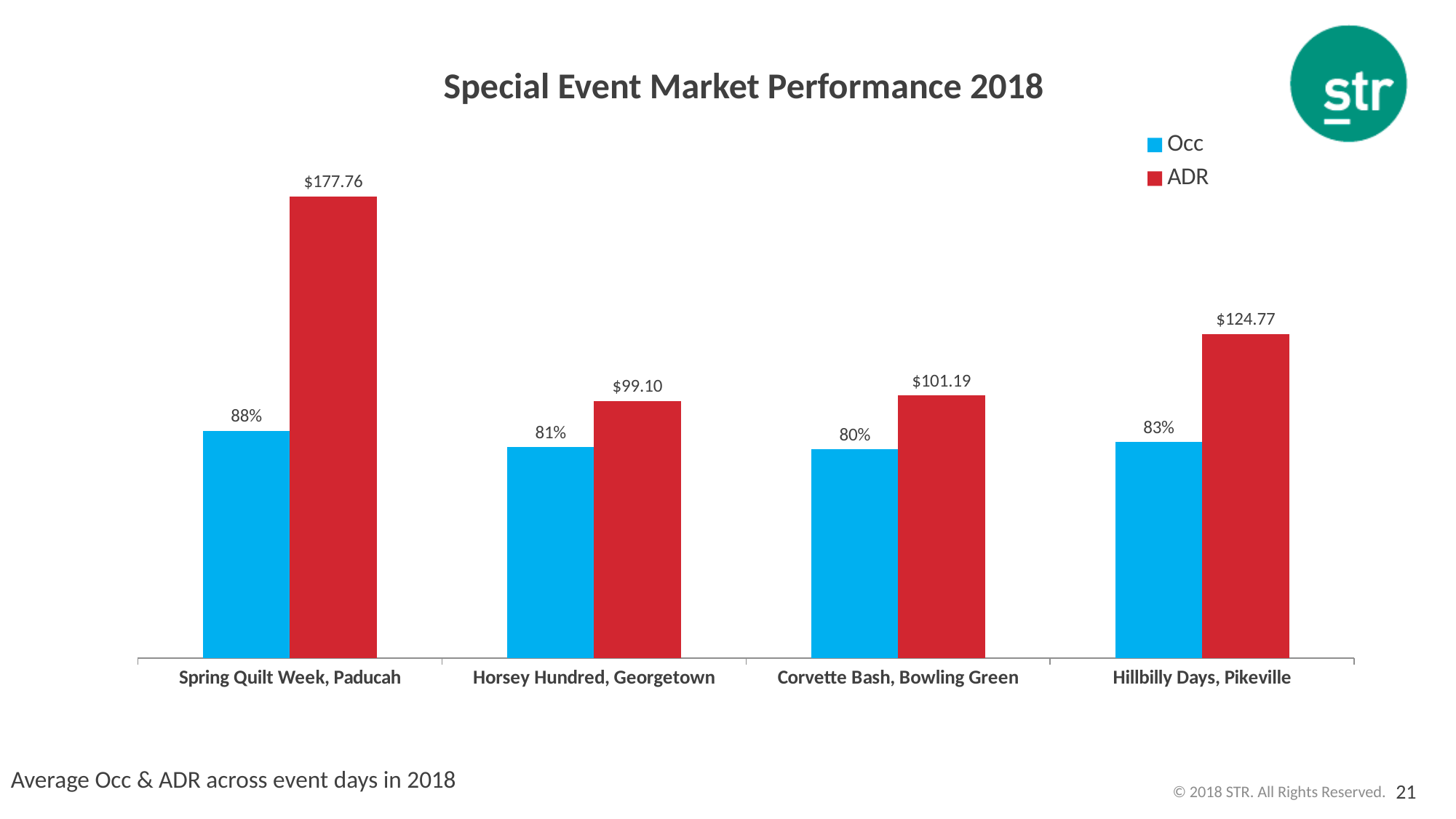
How many events are shown on the x axis? 4 What is the Occ value for Horsey Hundred, Georgetown? 81% Which event has the highest ADR? Spring Quilt Week, Paducah How many series does the legend list? 2 What is the ADR for Spring Quilt Week, Paducah? $177.76 What is the ADR for Hillbilly Days, Pikeville? $124.77 What is the Occ value for Corvette Bash, Bowling Green? 80% Which has a higher Occ, Spring Quilt Week, Paducah or Hillbilly Days, Pikeville? Spring Quilt Week, Paducah Which event has the lowest Occ? Corvette Bash, Bowling Green What type of chart is shown on the slide? Bar chart Which event has the lowest ADR? Horsey Hundred, Georgetown What is the difference in ADR between Spring Quilt Week, Paducah and Hillbilly Days, Pikeville? $52.99